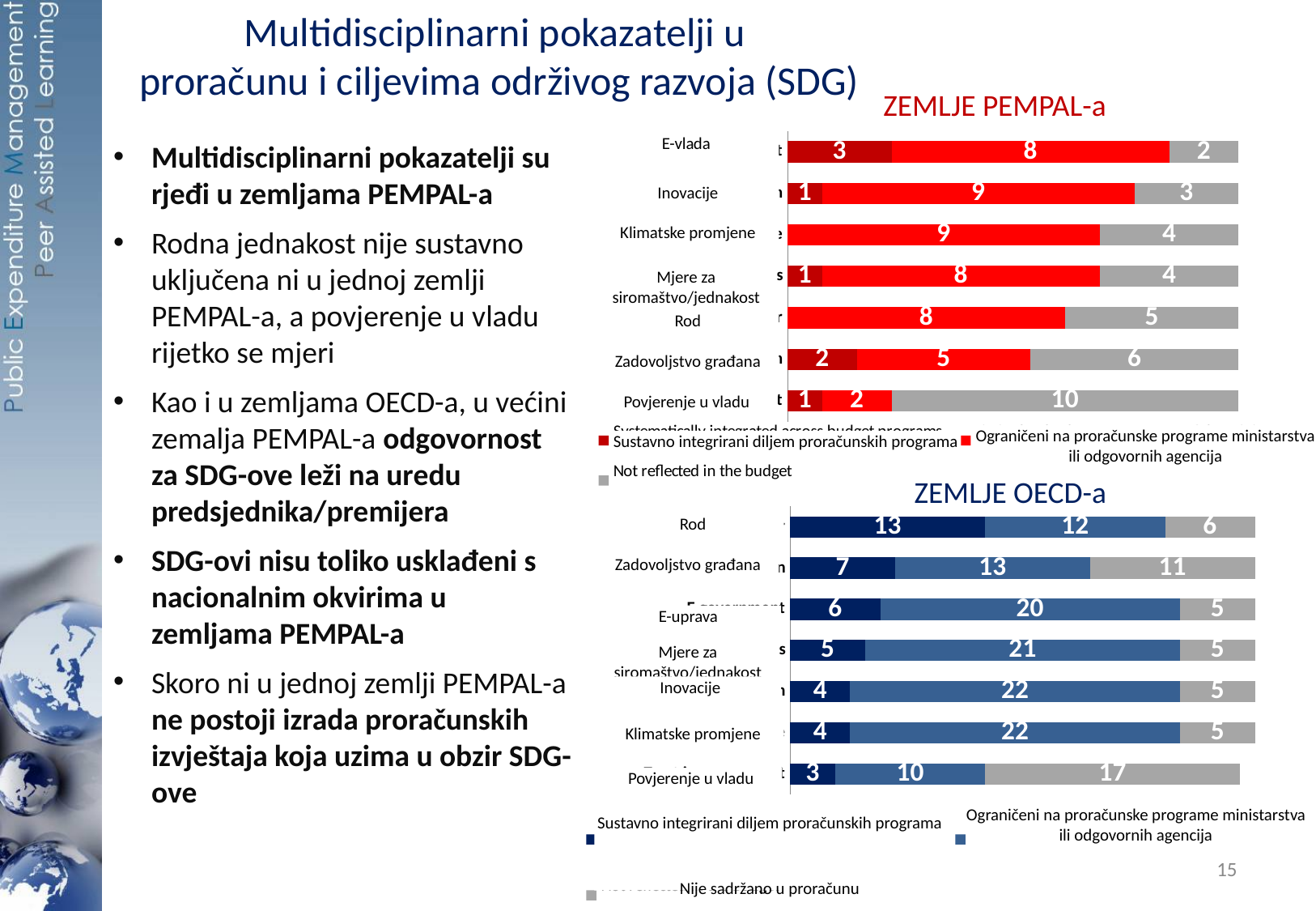
In the ZEMLJE PEMPAL-a chart, what is the value of the middle (Ograničeni na proračunske programe ministarstva ili odgovornih agencija) segment for Inovacije? 9 In the ZEMLJE OECD-a chart, what is the value of the 'Sustavno integrirani diljem proračunskih programa' segment for Rod? 13 In the ZEMLJE PEMPAL-a chart, what is the total of the stacked bar for E-vlada? 13 In the ZEMLJE PEMPAL-a chart, what is the value of the 'Nije sadržano u proračunu' (grey) segment for Povjerenje u vladu? 10 In the ZEMLJE OECD-a chart, what is the difference between the middle segment values for Inovacije and Zadovoljstvo građana? 9 In the ZEMLJE PEMPAL-a chart, which category has the highest value for the grey 'Nije sadržano u proračunu' series? Povjerenje u vladu In the ZEMLJE OECD-a chart, what is the total of the stacked bar for E-uprava? 31 In the ZEMLJE OECD-a chart, what is the value of the grey 'Nije sadržano u proračunu' segment for Povjerenje u vladu? 17 How many categories are shown in the ZEMLJE PEMPAL-a chart? 7 What type of chart is the ZEMLJE OECD-a chart? Stacked bar chart In the ZEMLJE OECD-a chart, is the middle segment value for Klimatske promjene larger or smaller than that for Povjerenje u vladu? larger In the ZEMLJE OECD-a chart, which category has the highest value for the 'Sustavno integrirani diljem proračunskih programa' series? Rod